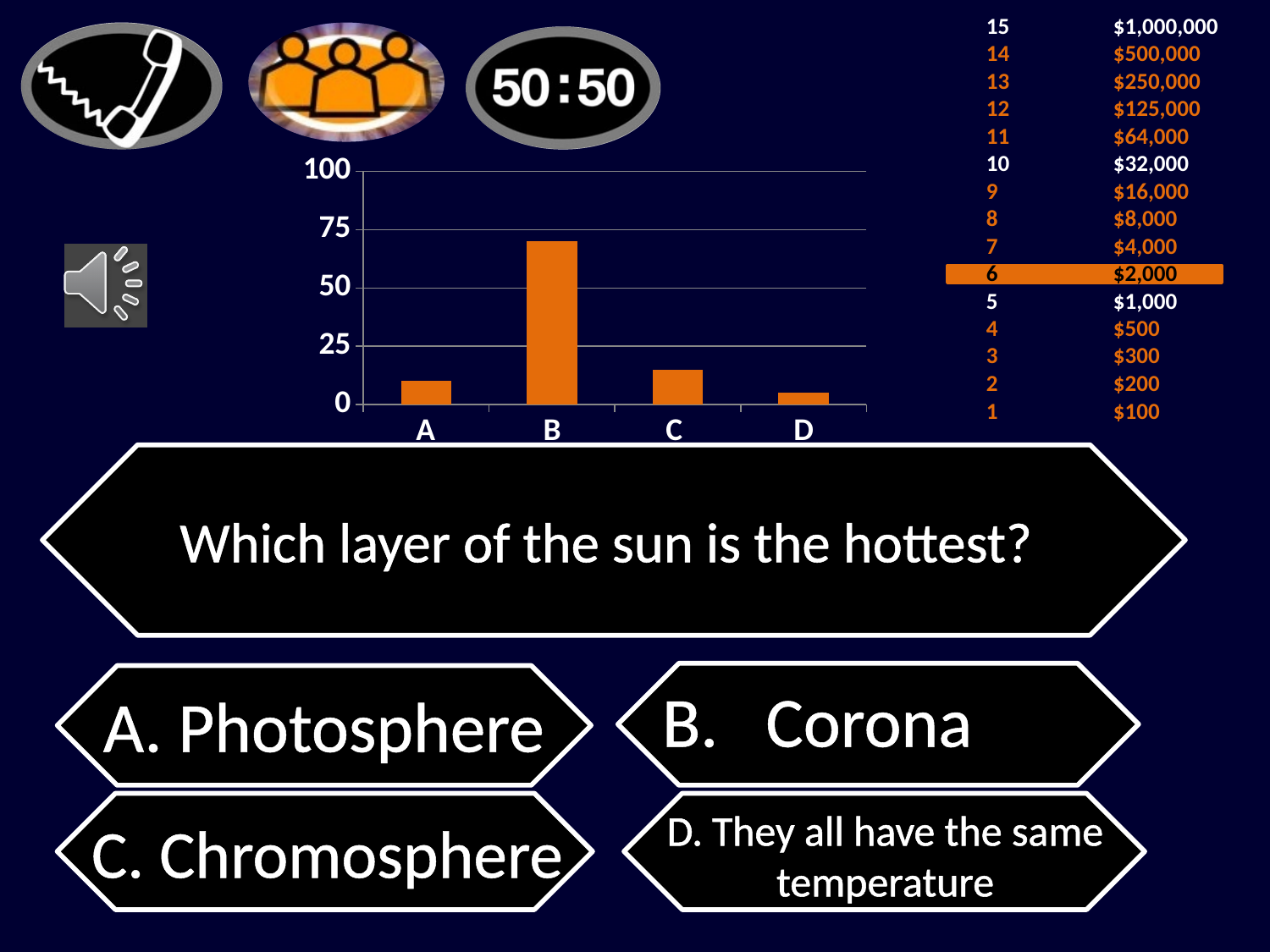
Which is larger, the value for B or the value for C? B Which is larger, the value for C or the value for D? C Is the value for A greater or less than 25? less Is the value for B greater or less than 50? greater Is the value for B greater or less than 75? less What colour are the bars in the chart? orange Which category has the highest bar in the chart? B What is the highest value shown on the y axis of the chart? 100 How many categories are shown on the x axis of the bar chart? 4 Which category has the lowest bar in the chart? D What kind of chart is shown on the slide? bar chart